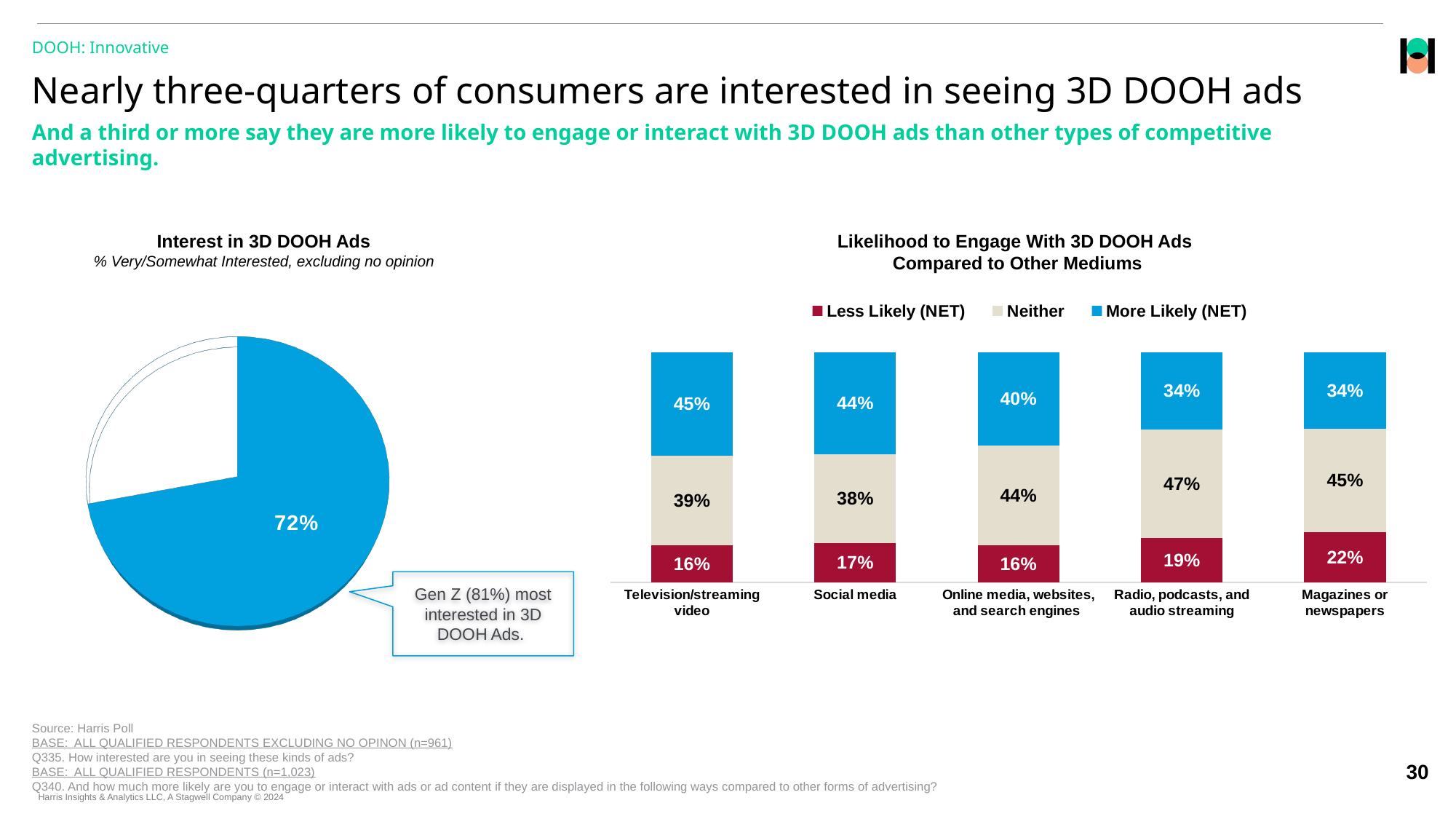
How many mediums are shown on the x axis of the 'Likelihood to Engage With 3D DOOH Ads' chart? 5 In the 'Likelihood to Engage With 3D DOOH Ads' chart, what is the More Likely (NET) value for Social media? 44% In the 'Likelihood to Engage With 3D DOOH Ads' chart, which medium has the highest More Likely (NET) value? Television/streaming video What kind of chart is the 'Likelihood to Engage With 3D DOOH Ads Compared to Other Mediums' chart? stacked bar chart What kind of chart is the 'Interest in 3D DOOH Ads' chart? pie chart In the 'Likelihood to Engage With 3D DOOH Ads' chart, what is the Less Likely (NET) value for Magazines or newspapers? 22% In the 'Interest in 3D DOOH Ads' pie chart, what percentage of consumers are very/somewhat interested? 72% In the 'Likelihood to Engage With 3D DOOH Ads' chart, what is the difference between the More Likely (NET) values for Television/streaming video and Magazines or newspapers? 11 percentage points In the 'Likelihood to Engage With 3D DOOH Ads' chart, which medium has the highest Less Likely (NET) value? Magazines or newspapers In the 'Likelihood to Engage With 3D DOOH Ads' chart, is the More Likely (NET) value larger for Online media, websites, and search engines or for Radio, podcasts, and audio streaming? Online media, websites, and search engines How many series does the legend of the 'Likelihood to Engage With 3D DOOH Ads' chart list? 3 In the 'Likelihood to Engage With 3D DOOH Ads' chart, what is the Neither value for Radio, podcasts, and audio streaming? 47%